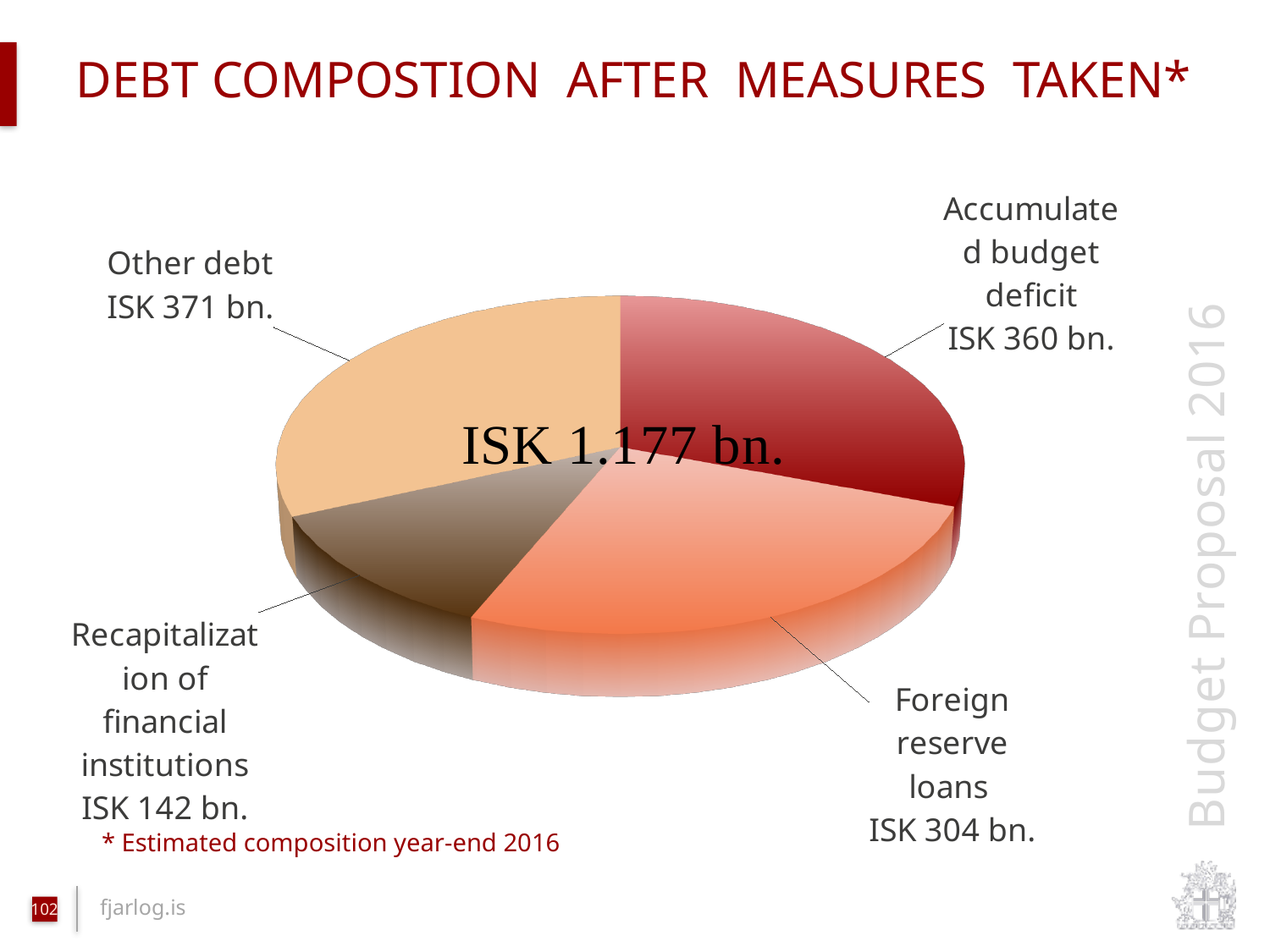
What is the value of the Foreign reserve loans slice? ISK 304 bn. Which category has the smallest value in the pie chart? Recapitalization of financial institutions What is the difference between Other debt and Accumulated budget deficit? ISK 11 bn. What kind of chart is shown on the slide? Pie chart What total value is printed in the centre of the pie chart? ISK 1.177 bn. What is the difference between Foreign reserve loans and Recapitalization of financial institutions? ISK 162 bn. How many slices does the pie chart have? 4 Which category has the largest value in the pie chart? Other debt Which is larger, Accumulated budget deficit or Foreign reserve loans? Accumulated budget deficit What is the value of the Other debt slice? ISK 371 bn. What is the value of the Accumulated budget deficit slice? ISK 360 bn. What is the value of the Recapitalization of financial institutions slice? ISK 142 bn.